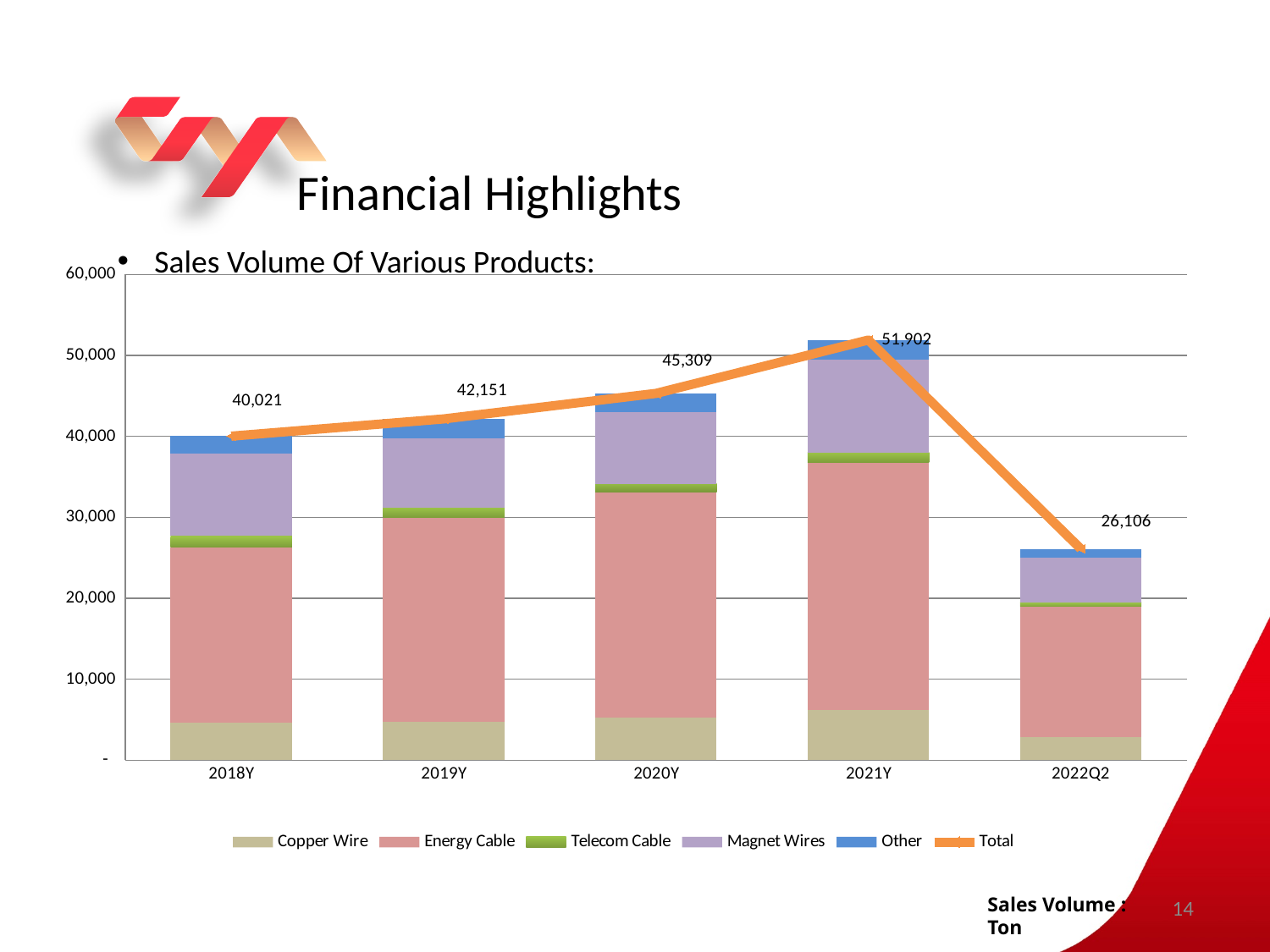
How many periods are shown on the x axis? 5 How many series does the legend list? 6 What is the Total sales volume for 2022Q2? 26,106 What is the Total sales volume for 2021Y? 51,902 Which period has the lowest Total sales volume? 2022Q2 Does the Total sales volume rise or fall from 2018Y to 2021Y? rise Which period has the highest Total sales volume? 2021Y Is the Copper Wire value for 2018Y greater or less than 10,000? less What kind of chart is shown on the slide? Stacked bar chart with a line for Total Which is larger, the Total sales volume in 2019Y or in 2020Y? 2020Y What is the Total sales volume for 2018Y? 40,021 What is the difference between the Total sales volume in 2021Y and 2020Y? 6,593